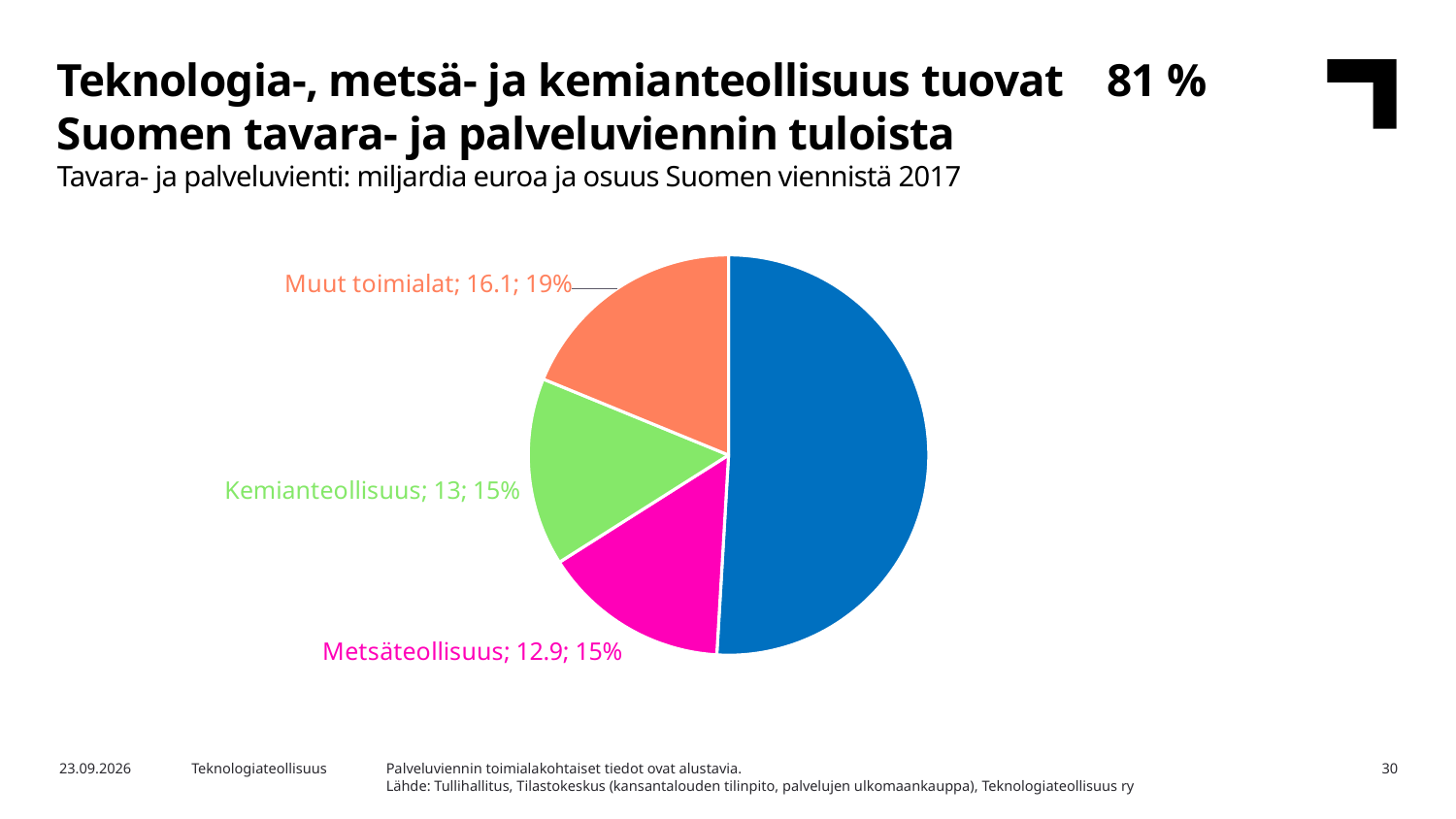
What value in billions of euros is shown for Kemianteollisuus? 13 What share of the pie does Muut toimialat represent? 19% What value in billions of euros is shown for Metsäteollisuus? 12.9 What share of the pie does Kemianteollisuus represent? 15% Which is larger, the value for Muut toimialat or the value for Metsäteollisuus? Muut toimialat What colour is the Kemianteollisuus slice? green How many slices does the pie chart have? 4 Among the labelled slices, which has the highest value? Muut toimialat What share of the pie does Metsäteollisuus represent? 15% What value in billions of euros is shown for Muut toimialat? 16.1 What is the difference in billions of euros between Muut toimialat and Kemianteollisuus? 3.1 What kind of chart is shown on the slide? pie chart